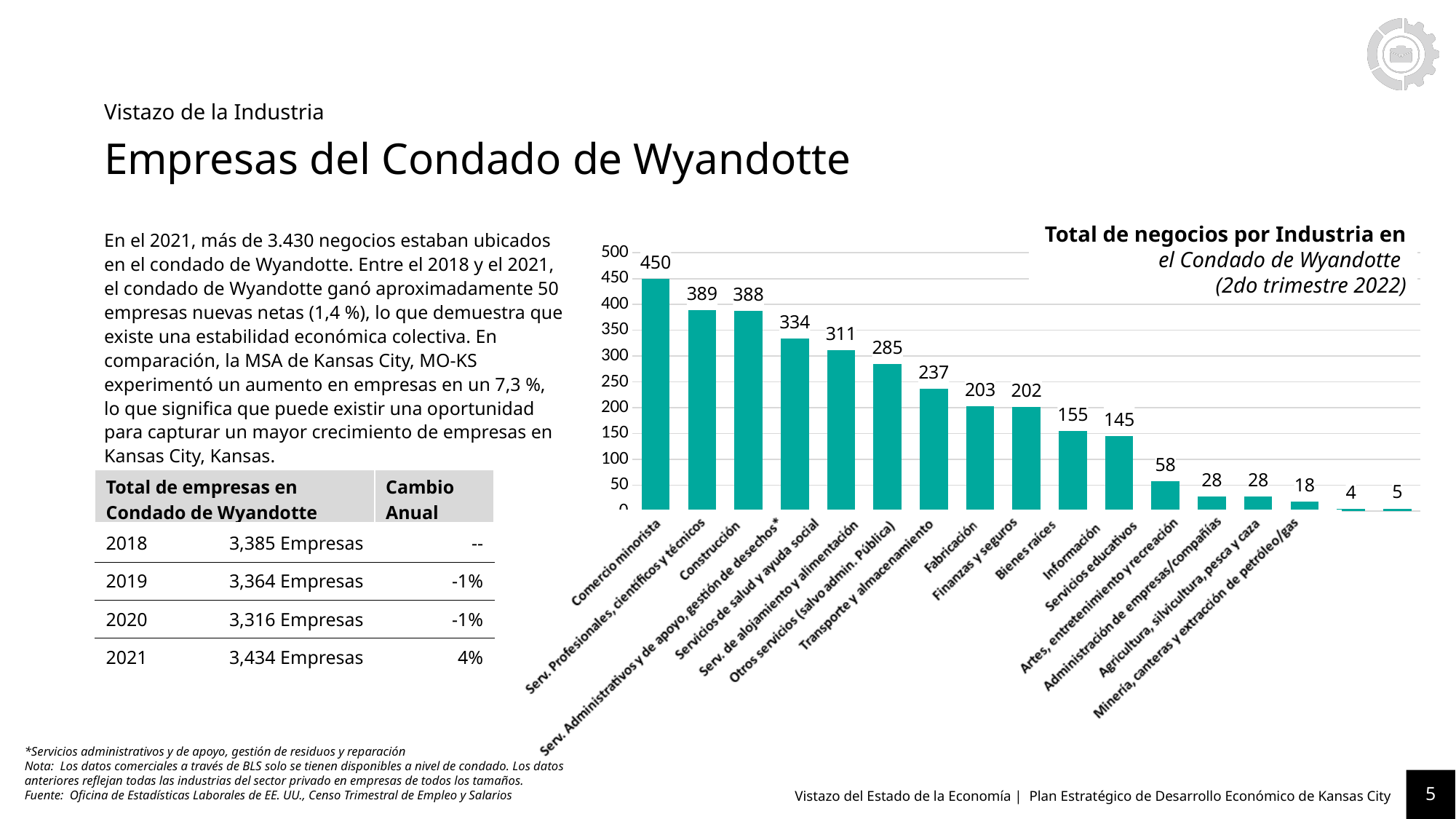
What type of chart is shown on the slide? bar chart How many industry categories are shown in the chart? 17 What is the value for Información? 58 What is the title of the chart? Total de negocios por Industria en el Condado de Wyandotte (2do trimestre 2022) Do the values rise or fall from left to right along the x axis? fall What is the value for Fabricación? 202 Which is larger, Finanzas y seguros or Bienes raíces? Finanzas y seguros What is the difference between Comercio minorista and Construcción? 62 What is the value for Comercio minorista? 450 What is the value for Construcción? 388 Which industry has the highest number of businesses? Comercio minorista Which industry has the lowest number of businesses? Agricultura, silvicultura, pesca y caza